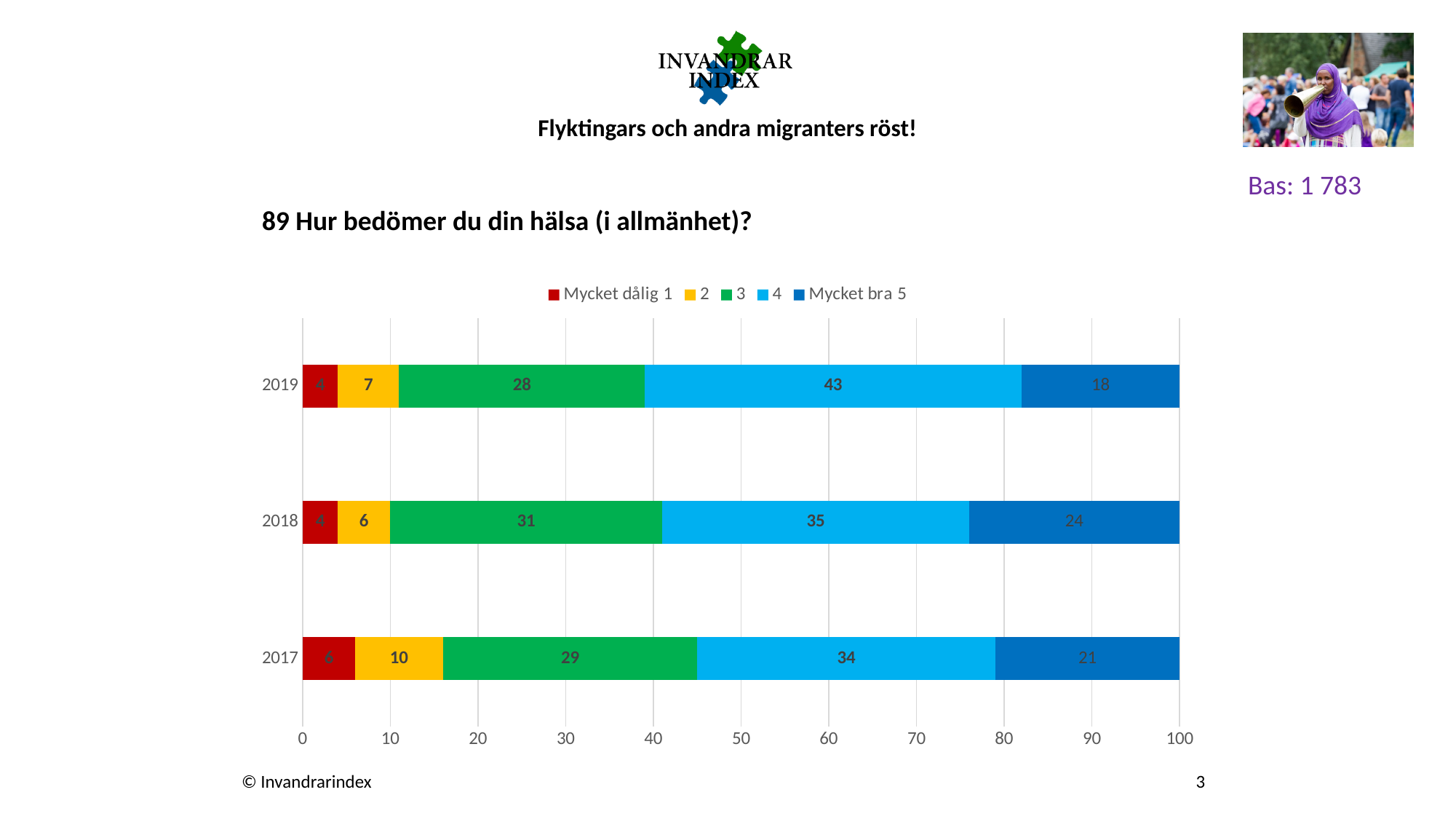
What is the value for "Mycket bra 5" in 2018? 24 What is the value for "Mycket dålig 1" in 2017? 6 What kind of chart is shown on the slide? Stacked bar chart How many years are shown on the chart? 3 Which year has the highest value for series "4"? 2019 What is the value for series "4" in 2019? 43 What is the total of the stacked bar for 2019? 100 What is the value for series "2" in 2017? 10 Which year has the lowest value for "Mycket bra 5"? 2019 What is the difference between the value for series "3" in 2018 and in 2019? 3 How many series does the legend list? 5 Which is larger: the value for "Mycket bra 5" in 2017 or in 2018? 2018